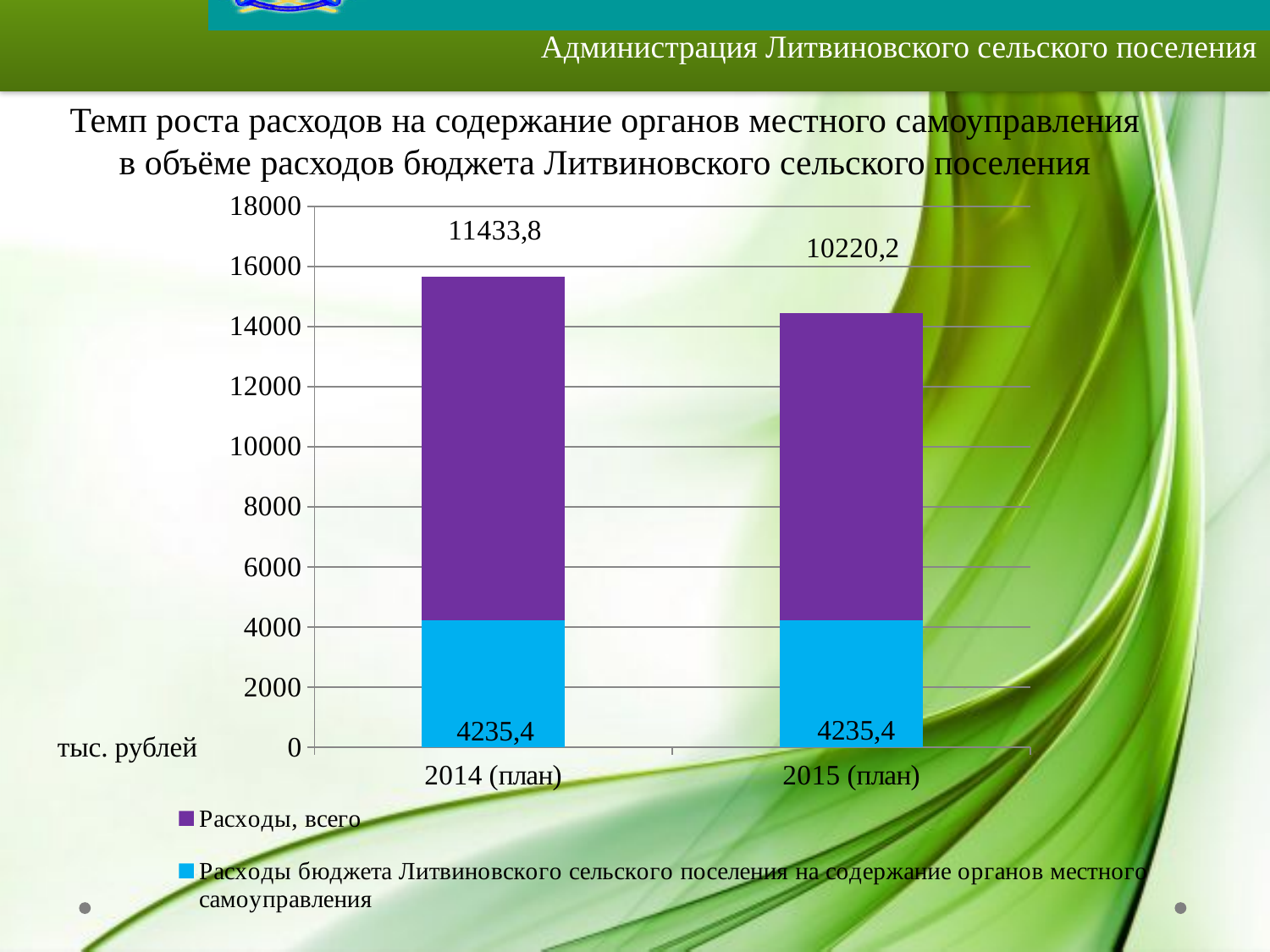
Is the "Расходы, всего" value for 2015 (план) larger or smaller than the value for 2014 (план)? smaller What is the difference between the "Расходы, всего" values for 2014 (план) and 2015 (план)? 1213,6 What is the value of the "Расходы, всего" series for 2015 (план)? 10220,2 What is the total of the stacked bar for 2014 (план)? 15669,2 What kind of chart is shown on the slide? stacked bar chart How many categories are shown on the x axis? 2 What is the value of the "Расходы бюджета Литвиновского сельского поселения на содержание органов местного самоуправления" series for 2015 (план)? 4235,4 In which year is the "Расходы, всего" value higher? 2014 (план) What is the total of the stacked bar for 2015 (план)? 14455,6 What is the value of the "Расходы, всего" series for 2014 (план)? 11433,8 What is the value of the "Расходы бюджета Литвиновского сельского поселения на содержание органов местного самоуправления" series for 2014 (план)? 4235,4 How many series does the legend list? 2